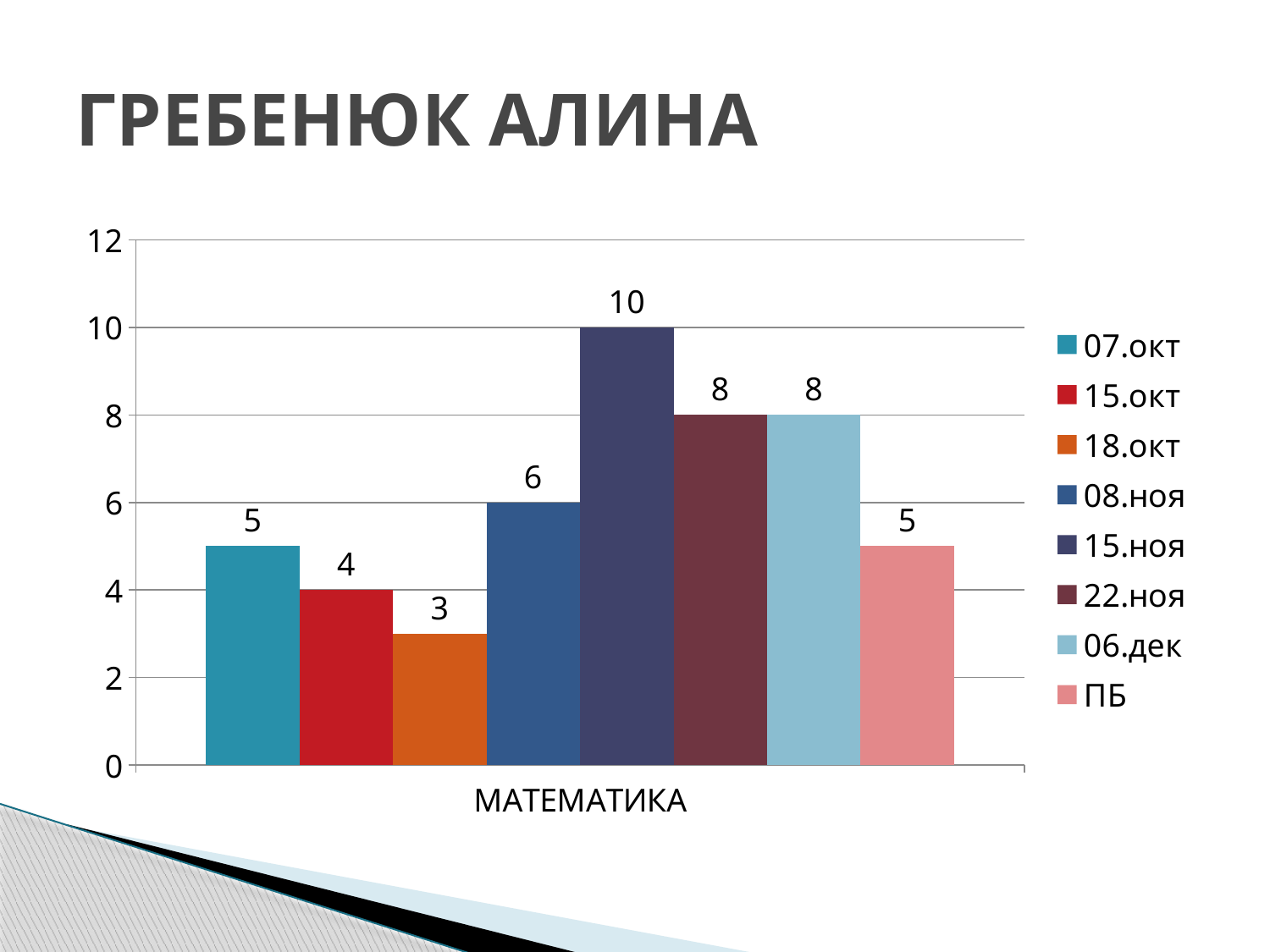
What is the title of the slide above the chart? ГРЕБЕНЮК АЛИНА Which series has the highest value? 15.ноя What kind of chart is shown on the slide? bar chart What is the difference between the values for 15.ноя and 15.окт? 6 Which is larger, the value for 07.окт or the value for 15.окт? 07.окт Which series has the lowest value? 18.окт What is the value for 15.ноя in the МАТЕМАТИКА chart? 10 What is the category label on the x axis? МАТЕМАТИКА How many series does the legend list? 8 What is the value for ПБ? 5 What is the value for 18.окт? 3 What is the value for 08.ноя? 6